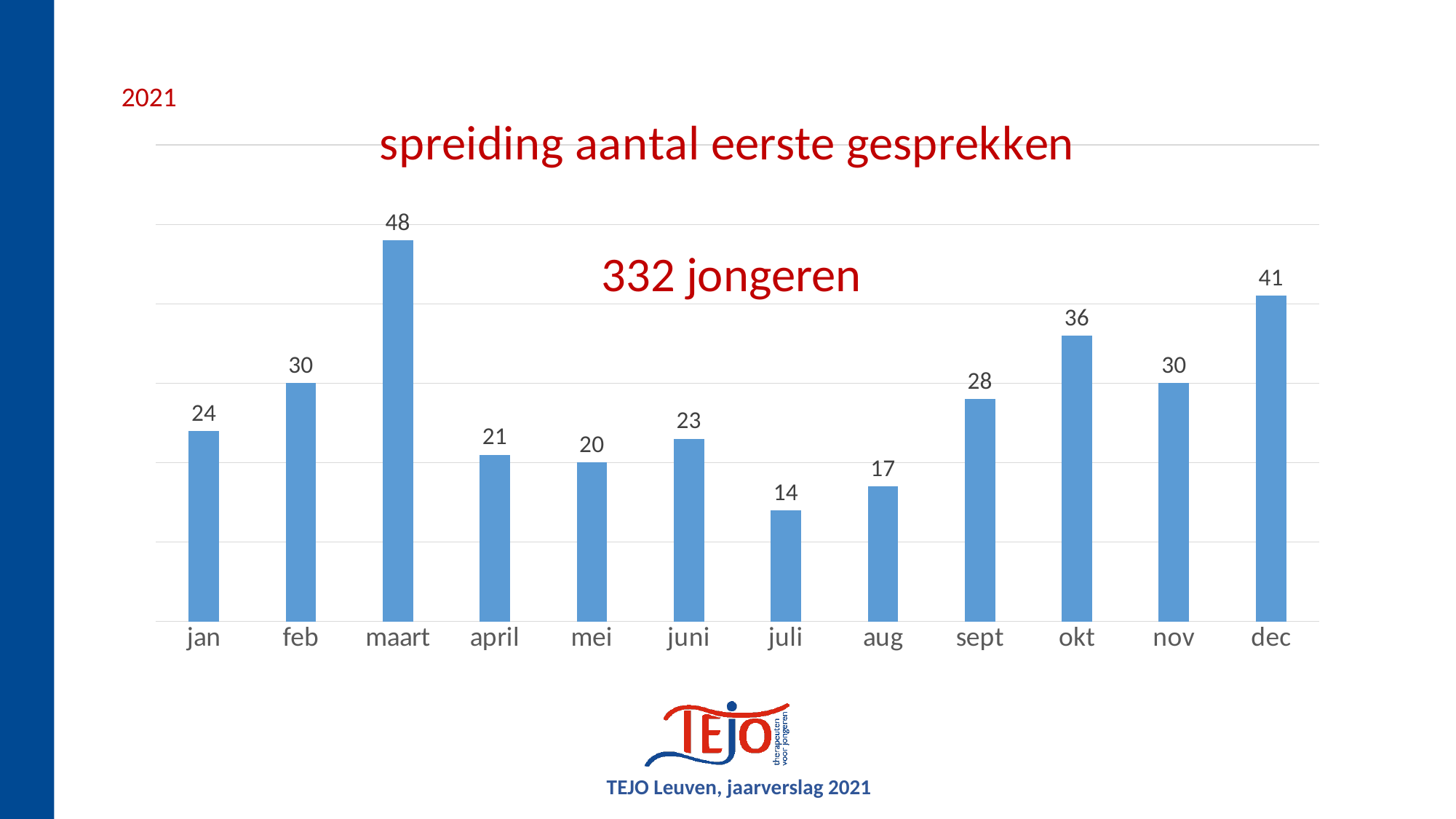
How many months are shown on the x axis? 12 What is the difference between the values for maart and juli? 34 Which month has the highest value? maart What kind of chart is shown? bar chart Which month has the lowest value? juli Which is larger, the value for sept or the value for aug? sept What is the difference between the values for dec and okt? 5 What is the value for maart? 48 What is the value for dec? 41 Do the values rise or fall from aug to dec? rise What is the value for juli? 14 What is the title of the chart? spreiding aantal eerste gesprekken